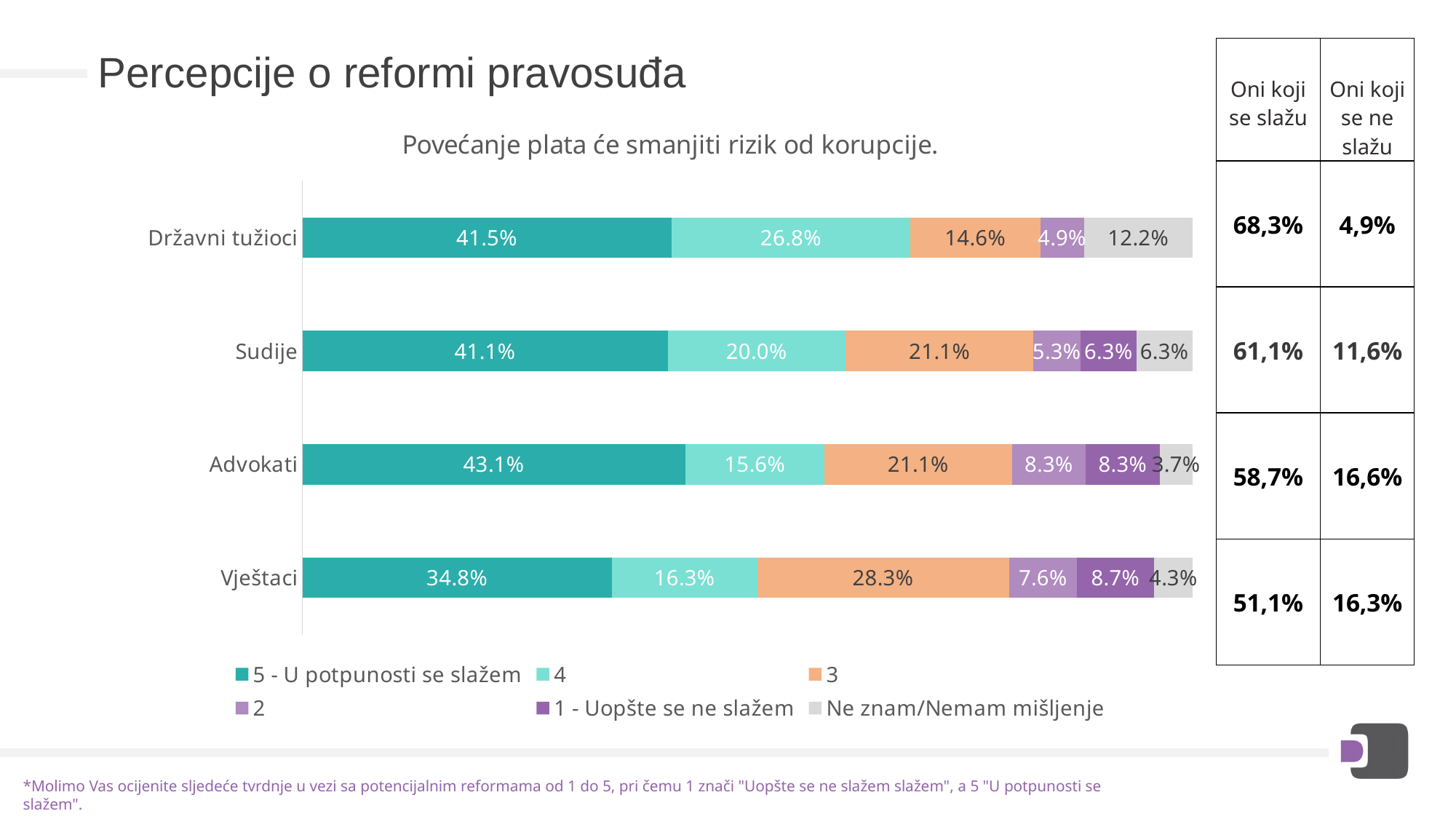
What share of Vještaci chose "5 - U potpunosti se slažem"? 34.8% How many percentage points higher is the "4" share for Državni tužioci than for Advokati? 11.2 percentage points What is the difference between the "1 - Uopšte se ne slažem" shares of Vještaci and Sudije? 2.4 percentage points Which group has the highest share of "5 - U potpunosti se slažem"? Advokati What type of chart is shown on the slide? Stacked bar chart How many series does the chart legend list? 6 How many groups (categories) are shown in the chart? 4 What is the value of the "2" segment for Advokati? 8.3% What percentage of Sudije answered "3" in the chart "Povećanje plata će smanjiti rizik od korupcije."? 21.1% Which group has a larger "3" share, Vještaci or Sudije? Vještaci Which group has the lowest "Ne znam/Nemam mišljenje" share? Advokati What is the "Ne znam/Nemam mišljenje" value for Državni tužioci? 12.2%